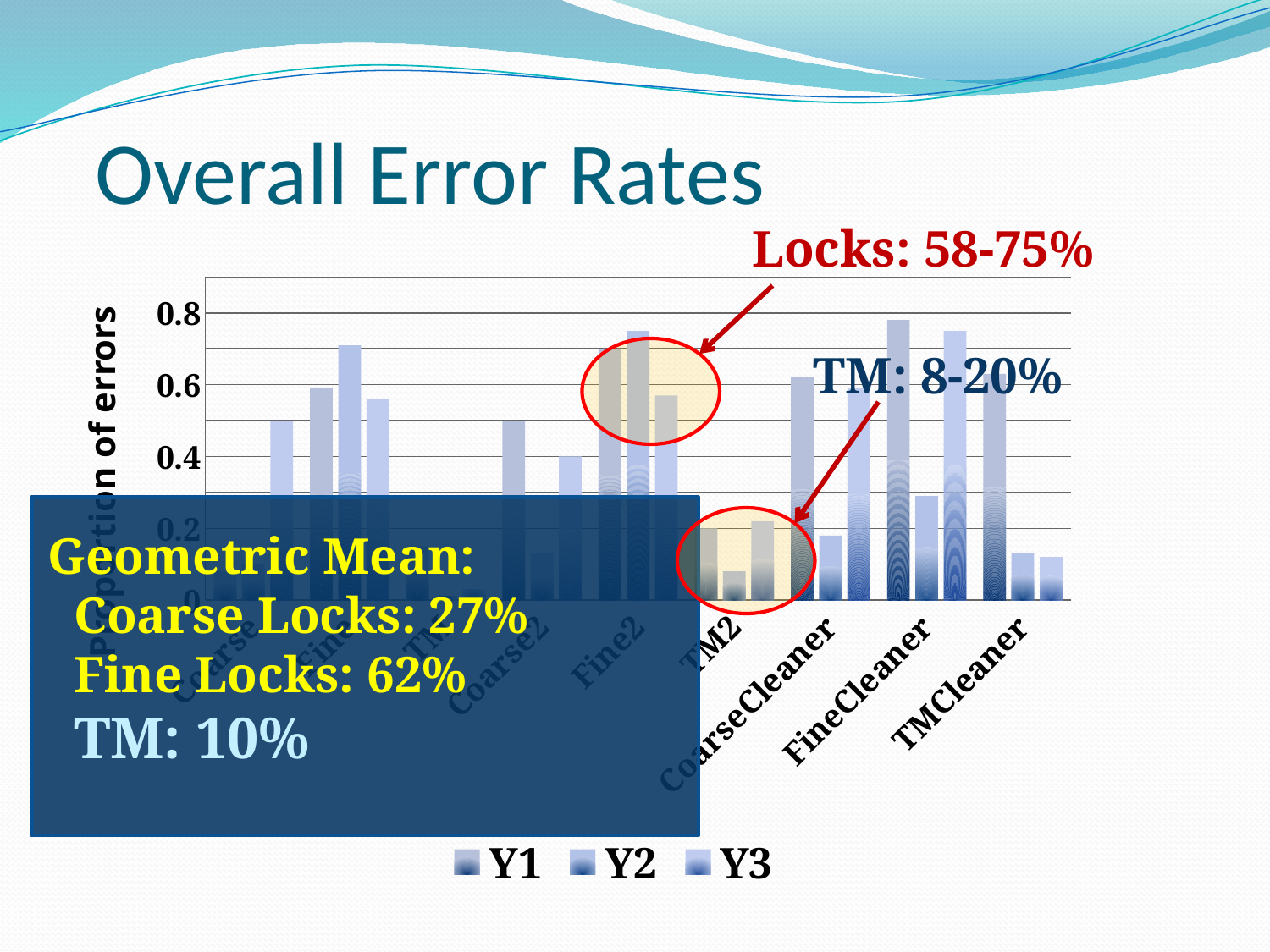
Is the tallest bar in the TM2 group greater or less than 0.4? less Is the shortest bar in the TMCleaner group greater or less than 0.2? less Is the tallest bar in the Fine2 group greater or less than 0.6? greater Which group has the taller tallest bar, FineCleaner or TMCleaner? FineCleaner What is the title of the slide containing the chart? Overall Error Rates How many series does the legend list? 3 What are the series names listed in the legend? Y1, Y2, Y3 What kind of chart is shown on the slide? bar chart Which group has the taller tallest bar, Fine2 or TM2? Fine2